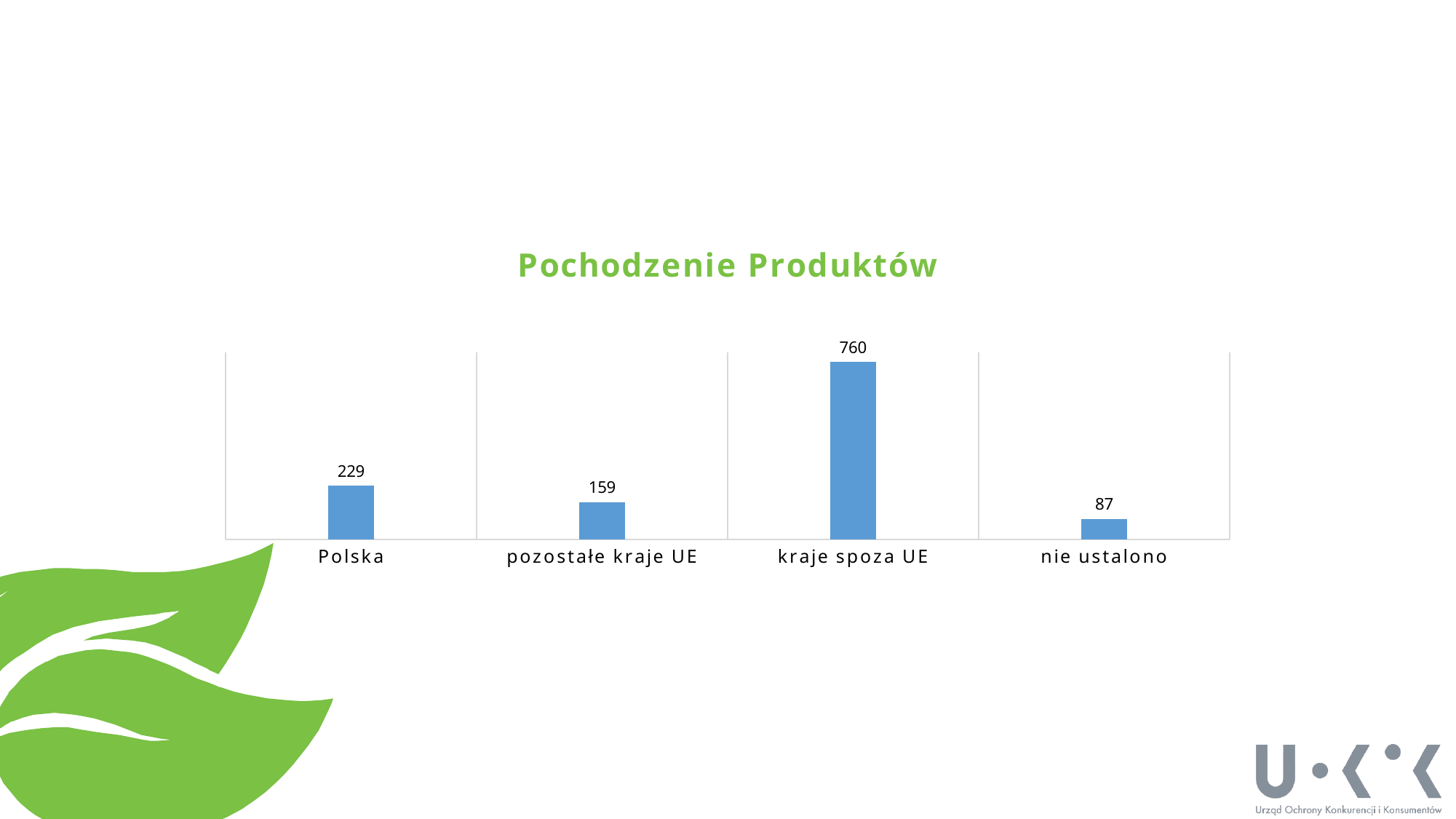
What is the value for pozostałe kraje UE? 159 Which category has the lowest value? nie ustalono What is the difference between the values for kraje spoza UE and Polska? 531 What is the title of the chart? Pochodzenie Produktów How many categories are shown on the chart? 4 Which is larger, the value for Polska or the value for nie ustalono? Polska Which category has the highest value? kraje spoza UE What is the difference between the values for Polska and pozostałe kraje UE? 70 What is the value for Polska? 229 What kind of chart is shown on the slide? bar chart What is the value for nie ustalono? 87 What is the value for kraje spoza UE? 760